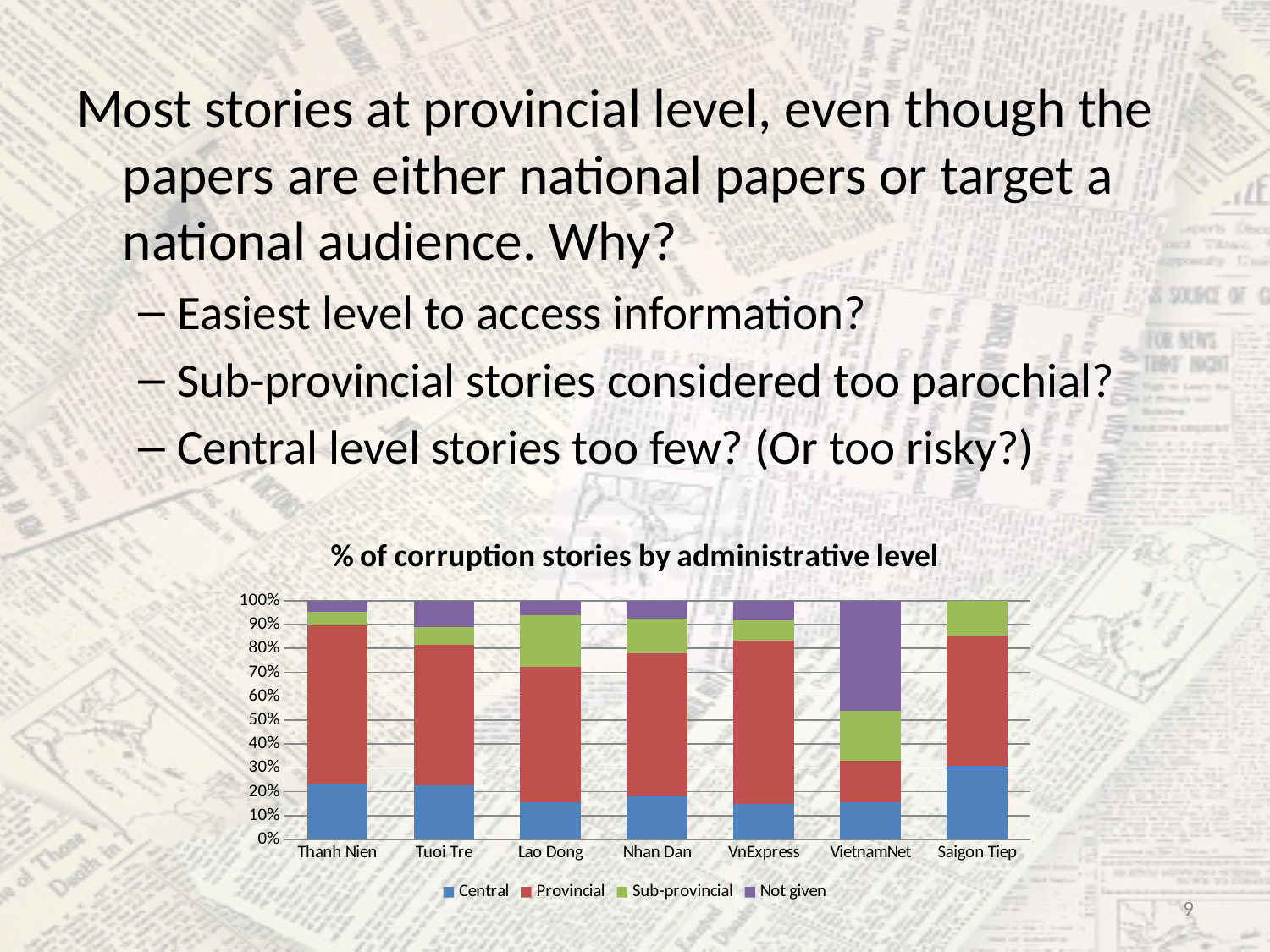
Which has the larger Central share, Saigon Tiep or Thanh Nien? Saigon Tiep Is the Not given share for VietnamNet greater or less than 40%? greater Which newspaper has the largest Central share in the chart? Saigon Tiep How many newspapers (categories) are shown on the x axis of the chart? 7 What is the title of the chart? % of corruption stories by administrative level Is the Central share for Saigon Tiep greater or less than 20%? greater Which newspaper has the largest Not given share in the chart? VietnamNet How many series does the chart's legend list? 4 Is the Central share for Lao Dong greater or less than 20%? less Which newspaper has the smallest Provincial share in the chart? VietnamNet Which newspaper shows no Not given segment at all? Saigon Tiep What kind of chart is shown on the slide? Stacked bar chart